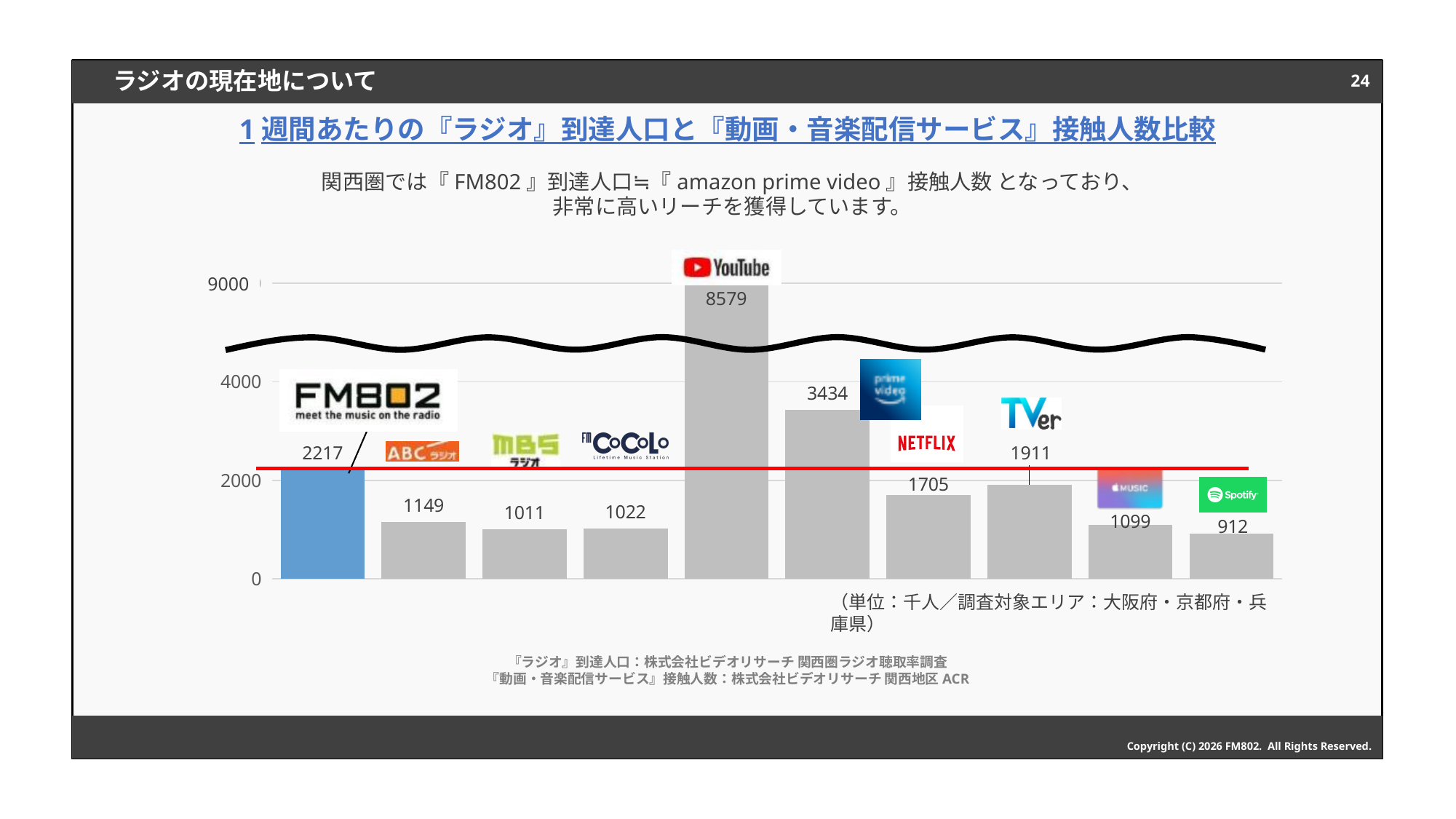
What is the value for TVer? 1911 What is the value for prime video? 3434 What kind of chart is shown on the slide? Bar chart What is the value for FM802? 2217 How many bars are in the chart? 10 What is the value for YouTube? 8579 What is the value for Spotify? 912 What is the difference between the values for FM802 and ABC Radio? 1068 Which category has the highest value? YouTube Which category has the lowest value? Spotify Which is larger, the value for Netflix or the value for TVer? TVer Which bar is coloured blue rather than grey? FM802